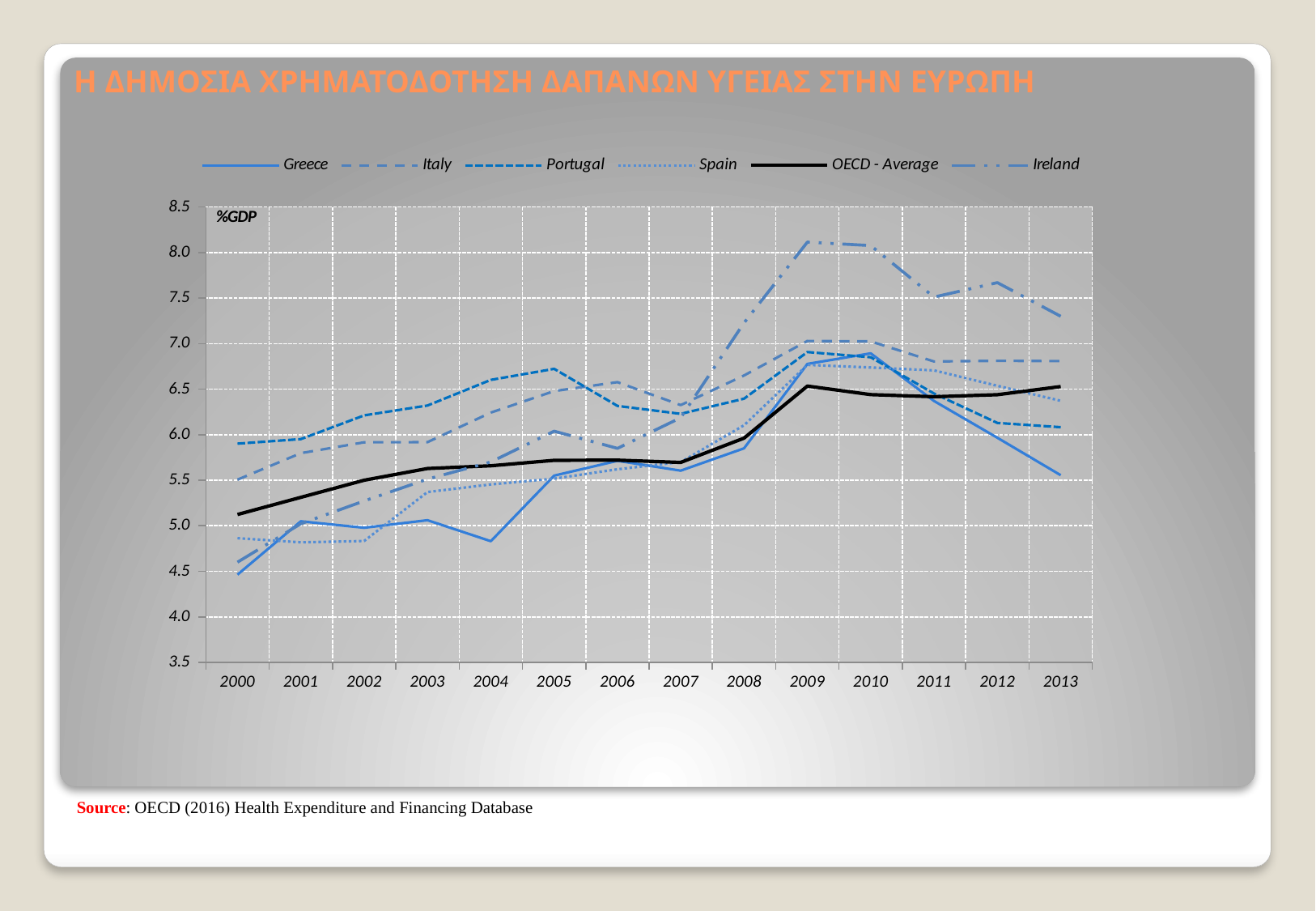
In 2013, which is larger: the value for Greece or the value for OECD - Average? OECD - Average How many years are shown on the x axis? 14 Is the value for Italy in 2013 greater or less than 6.5? greater Which series has the lowest value in 2013? Greece Is the value for Ireland in 2009 greater or less than 7.5? greater Is the value for OECD - Average in 2000 greater or less than 5.5? less What unit is shown on the y axis of the chart? %GDP What kind of chart is shown on the slide? line chart Which series has the highest value in 2009? Ireland How many series does the legend list? 6 Does the value for Greece rise or fall from 2009 to 2013? fall